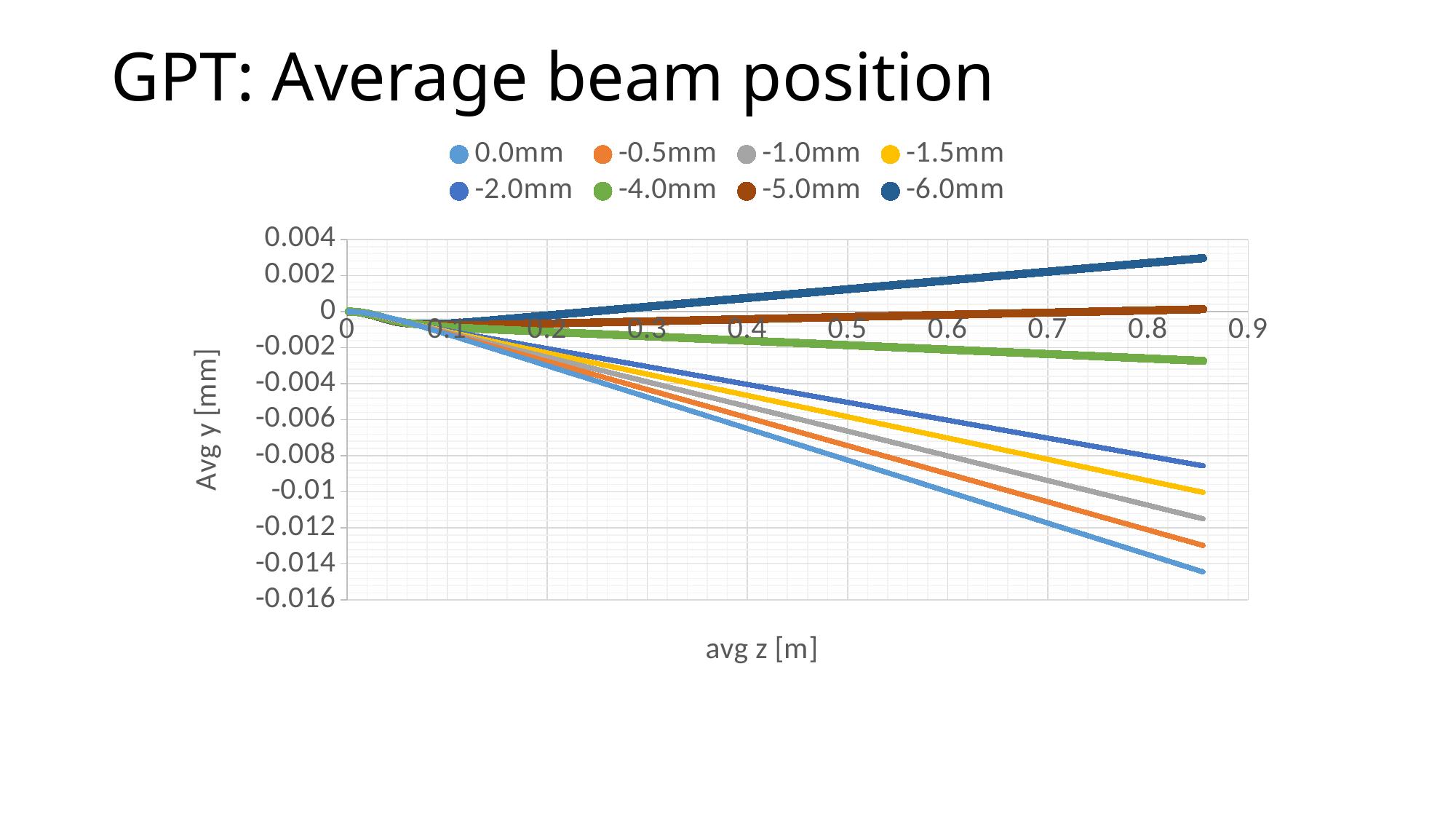
What is the title of the chart? GPT: Average beam position What kind of chart is shown on the slide? line chart At the right end of the chart, is the value for the 0.0mm series greater or less than -0.012? less Which series has the highest Avg y value at the right end of the chart? -6.0mm At the right end of the chart, which series has the larger Avg y value, -0.5mm or -1.0mm? -1.0mm Does the 0.0mm series rise or fall as avg z increases? fall At the right end of the chart, is the value for the -6.0mm series greater or less than 0.002? greater Which series has the lowest Avg y value at the right end of the chart? 0.0mm What is the label of the y axis? Avg y [mm] At the right end of the chart, is the value for the -4.0mm series greater or less than -0.002? less How many series does the legend list? 8 Does the -6.0mm series rise or fall as avg z increases? rise